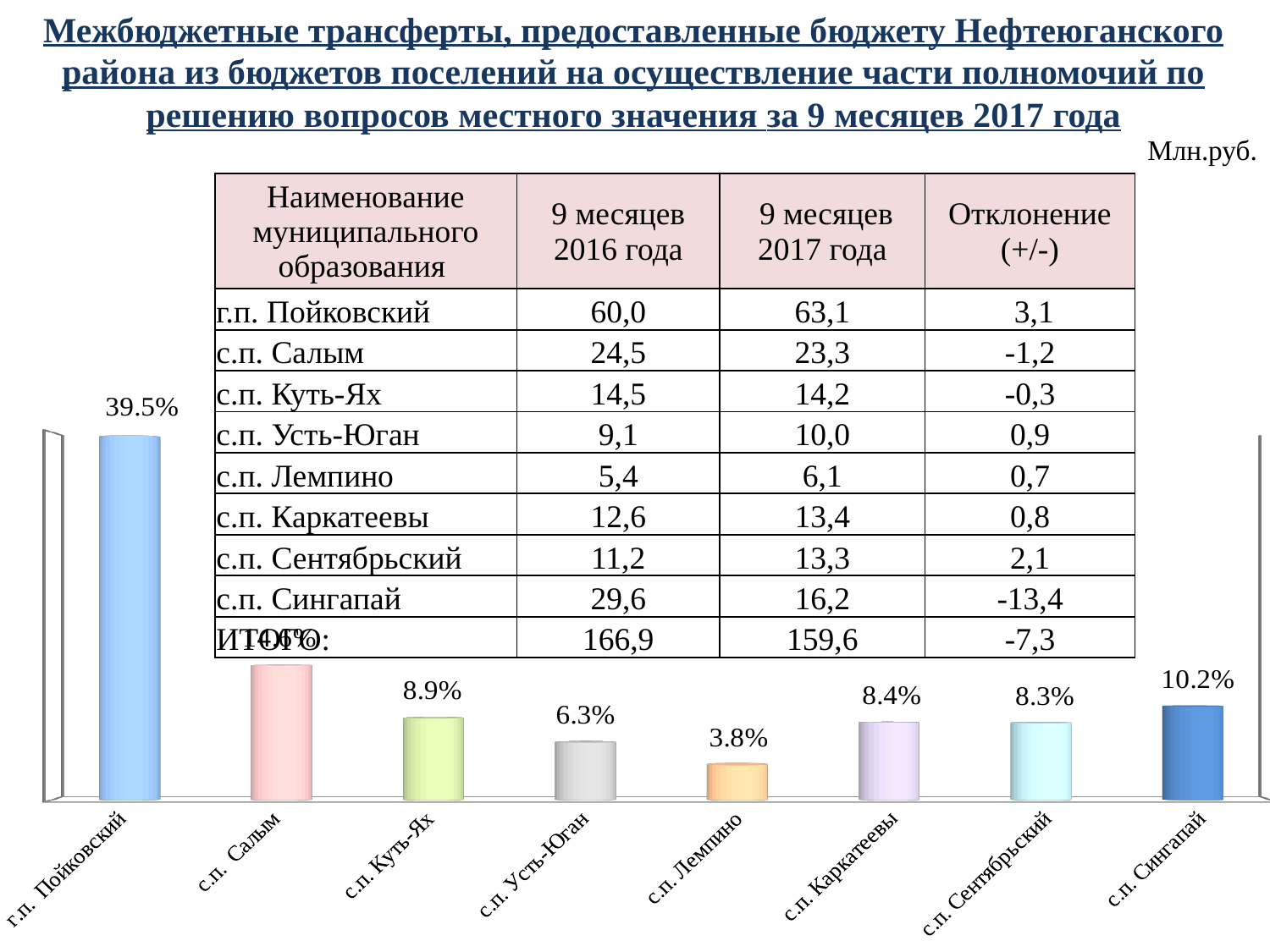
What is the difference between the values for г.п. Пойковский and с.п. Лемпино in the bar chart? 35.7% What is the value shown for г.п. Пойковский in the bar chart? 39.5% What kind of chart is shown on the slide? bar chart Which category has the highest value in the bar chart? г.п. Пойковский How many categories (municipalities) are plotted in the bar chart? 8 What is the value shown for с.п. Лемпино in the bar chart? 3.8% What is the value shown for с.п. Сингапай in the bar chart? 10.2% What is the difference between the values for с.п. Сингапай and с.п. Куть-Ях in the bar chart? 1.3% What is the value shown for с.п. Куть-Ях in the bar chart? 8.9% Which category has the lowest value in the bar chart? с.п. Лемпино Which has a larger value in the bar chart, с.п. Сингапай or с.п. Куть-Ях? с.п. Сингапай What is the value shown for с.п. Усть-Юган in the bar chart? 6.3%